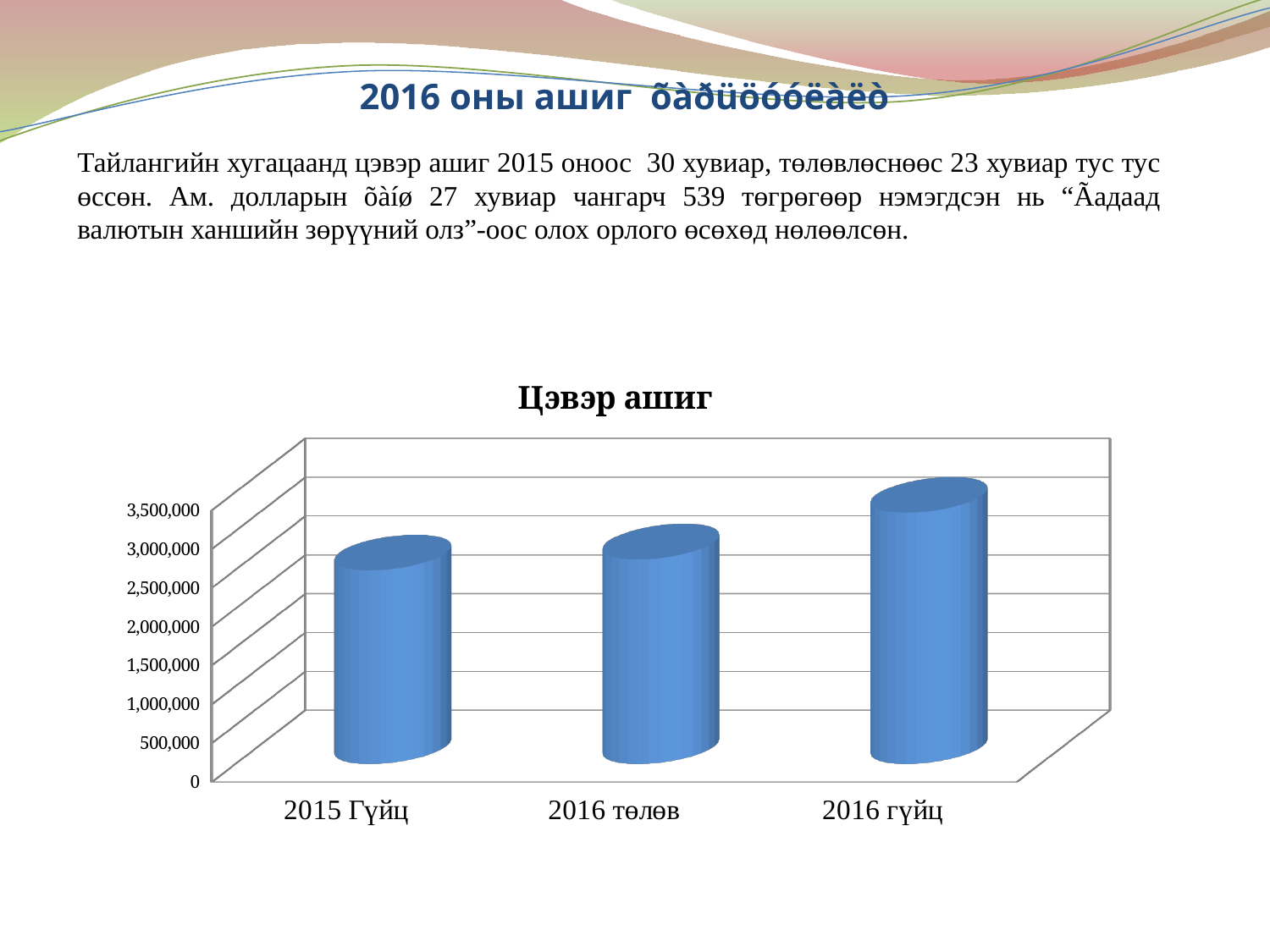
How many categories are shown on the x axis of the chart? 3 Which is larger, the value for 2016 гүйц or the value for 2015 Гүйц? 2016 гүйц Is the value for 2016 төлөв greater or less than 2,000,000? greater Is the value for 2015 Гүйц greater or less than 2,000,000? greater What is the title of the chart? Цэвэр ашиг What type of chart is shown on the slide? bar chart Do the values rise or fall from left to right along the x axis? rise Is the value for 2015 Гүйц greater or less than 3,000,000? less What is the highest tick value shown on the vertical axis? 3,500,000 What is the label of the first category on the x axis? 2015 Гүйц Which category has the highest value in the chart? 2016 гүйц